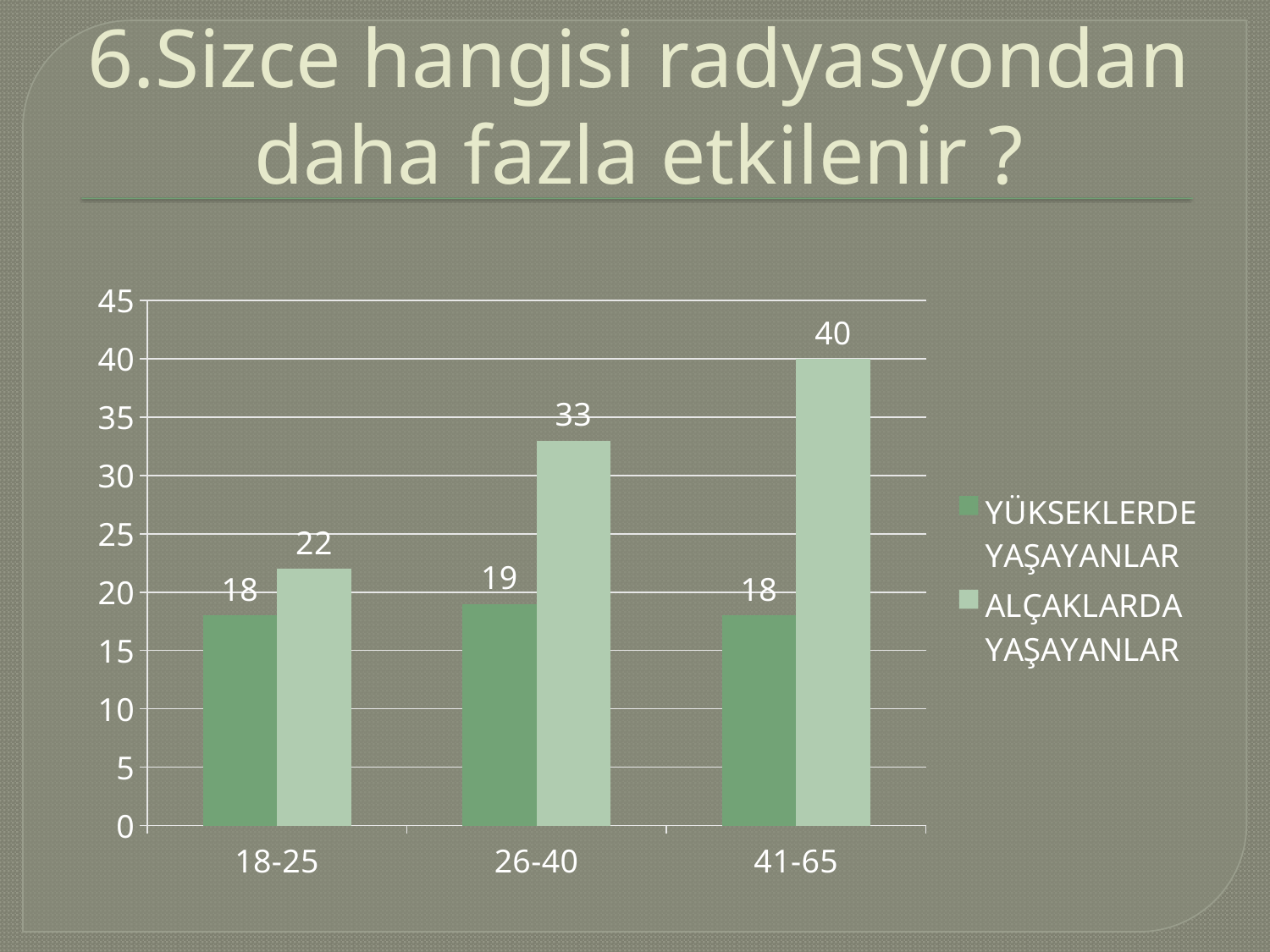
What is the difference between ALÇAKLARDA YAŞAYANLAR and YÜKSEKLERDE YAŞAYANLAR in the 41-65 age group? 22 What is the value for ALÇAKLARDA YAŞAYANLAR in the 26-40 age group? 33 Which age group has the lowest value for ALÇAKLARDA YAŞAYANLAR? 18-25 Is the value for ALÇAKLARDA YAŞAYANLAR in the 26-40 age group greater or less than 30? greater What kind of chart is shown on the slide? bar chart Which age group has the highest value for ALÇAKLARDA YAŞAYANLAR? 41-65 What is the value for YÜKSEKLERDE YAŞAYANLAR in the 18-25 age group? 18 Which is larger in the 26-40 age group, YÜKSEKLERDE YAŞAYANLAR or ALÇAKLARDA YAŞAYANLAR? ALÇAKLARDA YAŞAYANLAR What is the value for ALÇAKLARDA YAŞAYANLAR in the 41-65 age group? 40 How many age groups are shown on the x axis? 3 How many series does the legend list? 2 Do the values for ALÇAKLARDA YAŞAYANLAR rise or fall from 18-25 to 41-65? rise